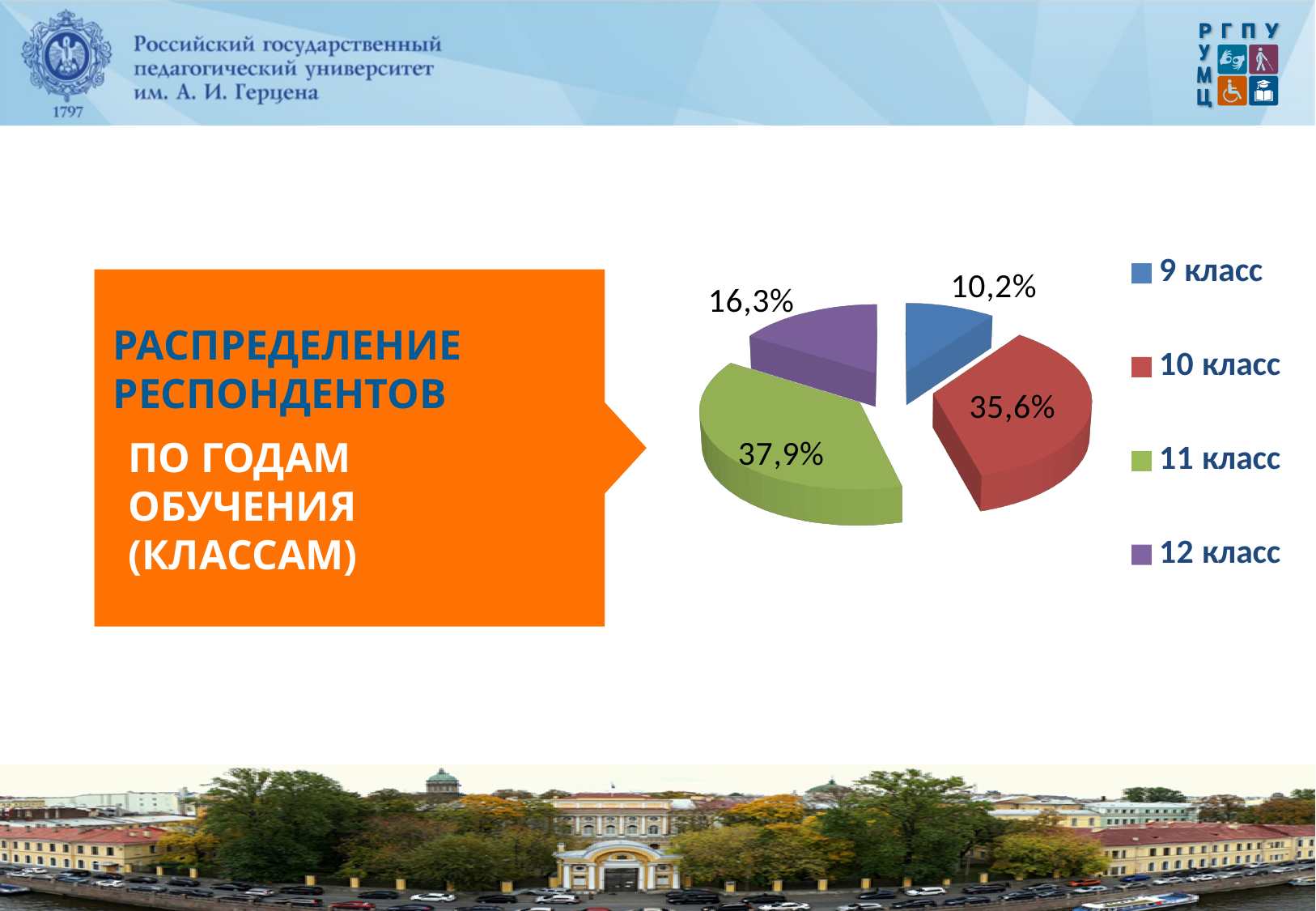
Which class has the smallest share of respondents? 9 класс What is the difference in percentage points between the shares for 11 класс and 10 класс? 2,3 Which is larger: the share for 10 класс or the share for 12 класс? 10 класс What share of respondents are in 10 класс? 35,6% What share of respondents are in 11 класс? 37,9% Which class has the largest share of respondents? 11 класс What share of respondents are in 9 класс? 10,2% What colour is the slice for 11 класс? Green How many slices does the pie chart have? 4 What is the difference in percentage points between the shares for 12 класс and 9 класс? 6,1 What share of respondents are in 12 класс? 16,3% What type of chart is shown on the slide? Pie chart